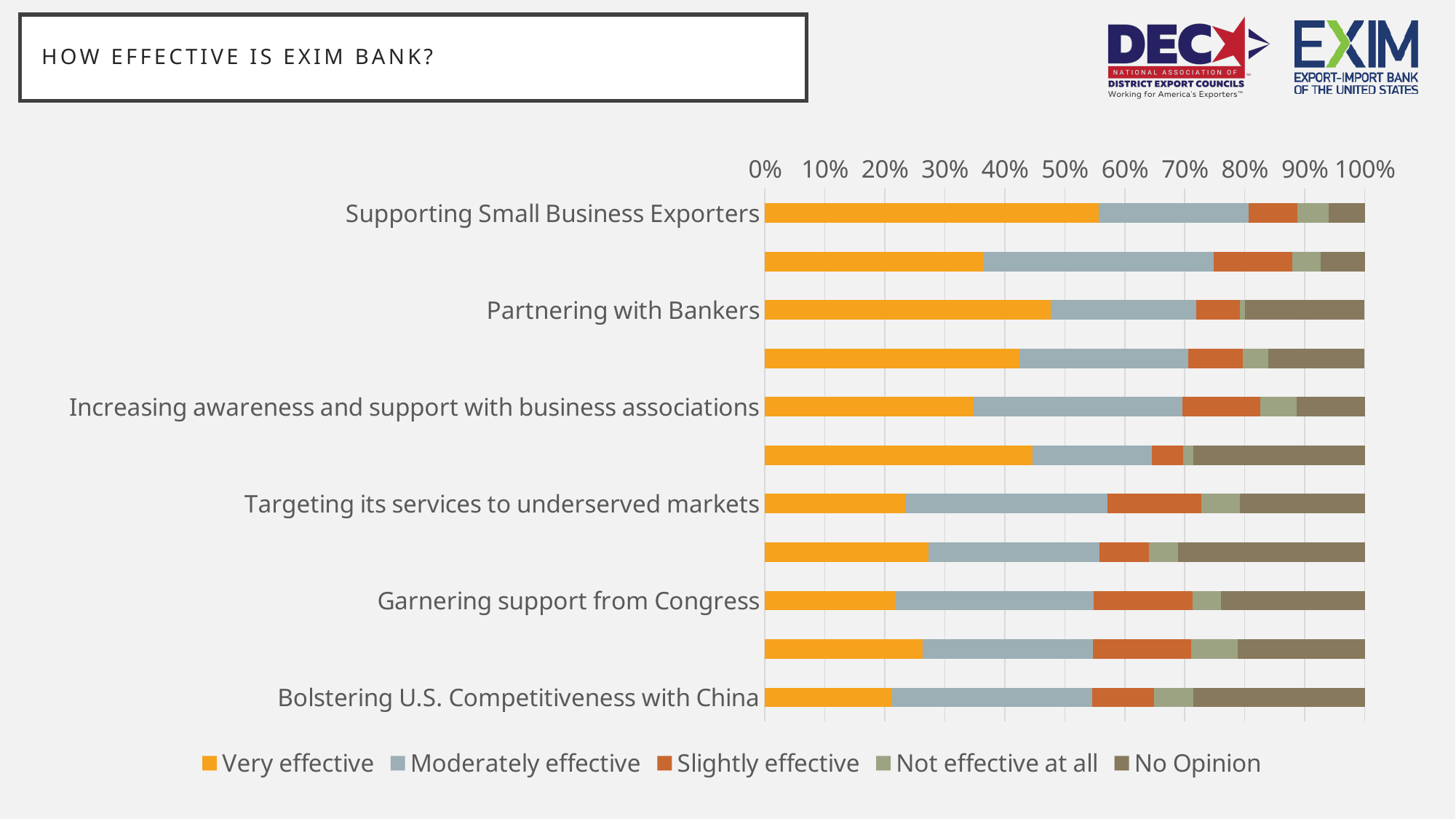
Is the 'Very effective' share for Increasing awareness and support with business associations greater or less than 40%? less Among the labeled categories, which has the largest 'Very effective' share? Supporting Small Business Exporters How many bars are plotted in the chart? 11 How many series does the legend list? 5 Is the 'Very effective' share for Supporting Small Business Exporters greater or less than 50%? greater What is the title of the slide? HOW EFFECTIVE IS EXIM BANK? What kind of chart is shown on the slide? Stacked bar chart Which has the larger 'No Opinion' share: Supporting Small Business Exporters or Bolstering U.S. Competitiveness with China? Bolstering U.S. Competitiveness with China Which colour represents 'Very effective' in the legend? Orange Is the 'Very effective' share for Partnering with Bankers greater or less than 40%? greater